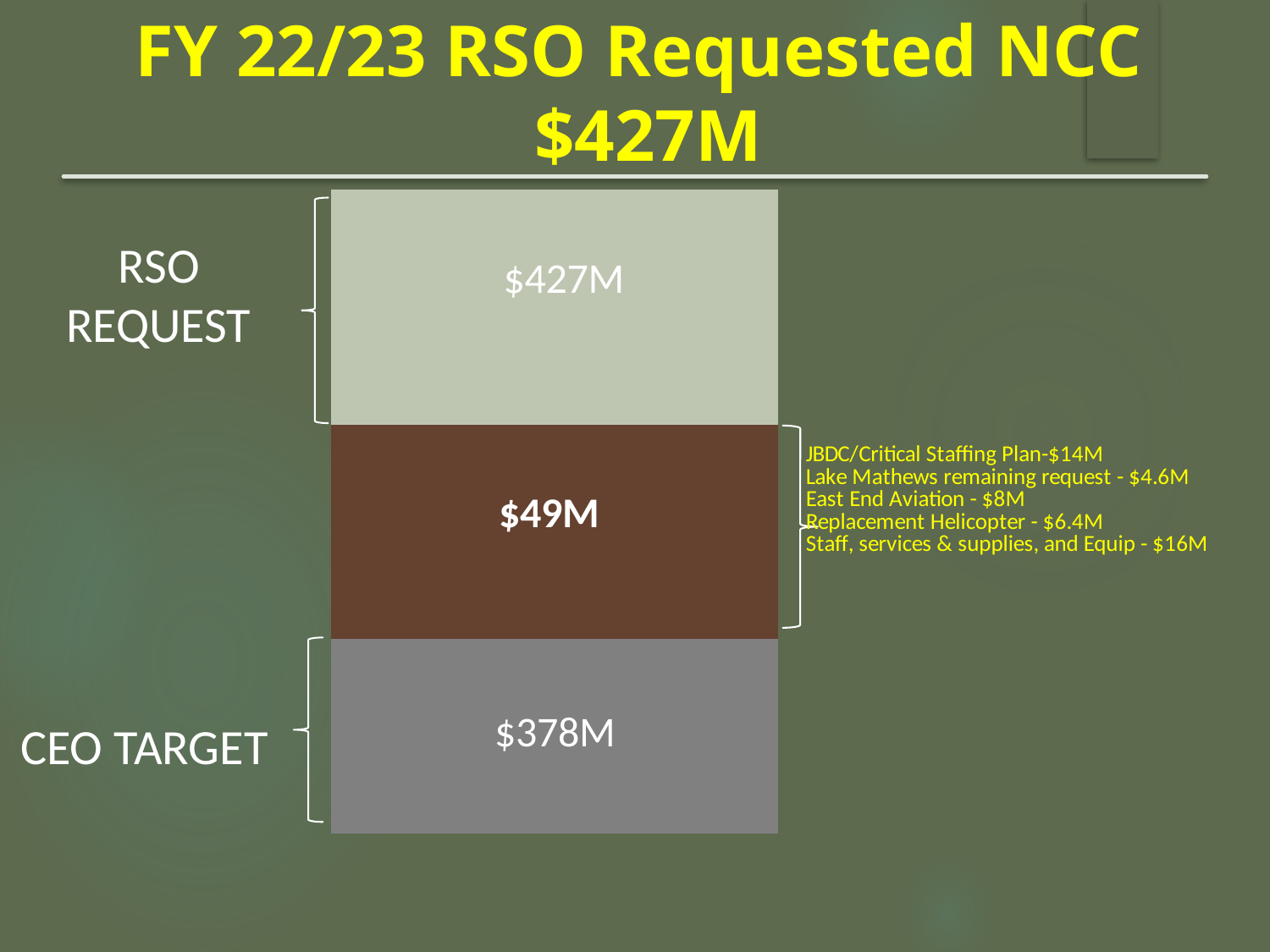
What value is printed on the brown middle segment of the bar? $49M What kind of chart is shown on the slide? Bar chart What value is shown for the RSO REQUEST segment of the bar? $427M Which item in the annotation next to the $49M segment has the largest amount? Staff, services & supplies, and Equip - $16M Which is larger, the RSO REQUEST or the CEO TARGET? RSO REQUEST What amount is listed for Replacement Helicopter in the annotation? $6.4M What is the title of the slide? FY 22/23 RSO Requested NCC $427M What value is shown for the CEO TARGET segment of the bar? $378M Which item in the annotation next to the $49M segment has the smallest amount? Lake Mathews remaining request - $4.6M What is the difference between the RSO REQUEST value and the CEO TARGET value? $49M How many segments make up the bar on the slide? 3 What amount is listed for JBDC/Critical Staffing Plan in the annotation next to the $49M segment? $14M